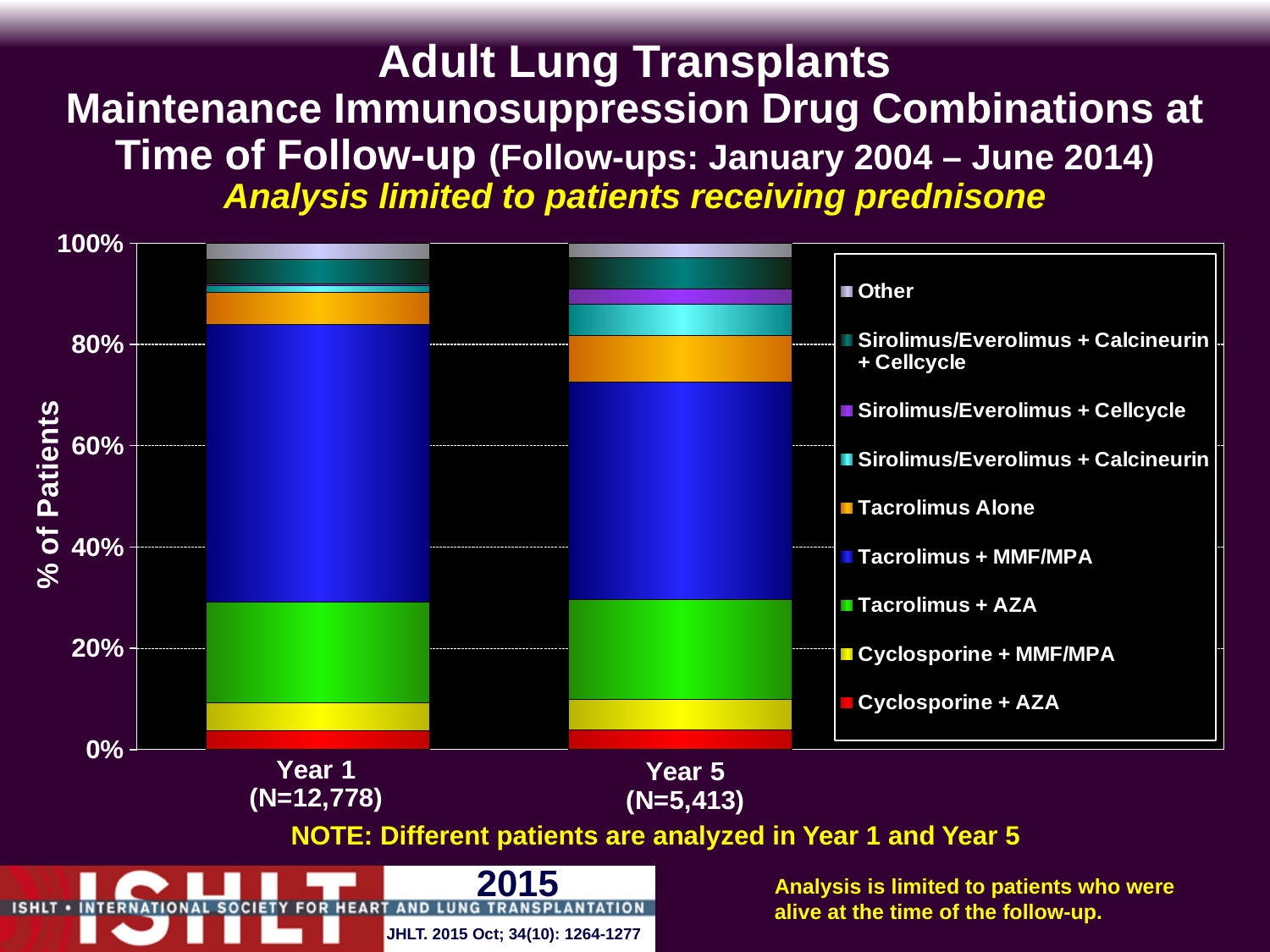
Is the share of Cyclosporine + AZA in Year 1 greater or less than 20%? less How many bars (follow-up time points) are plotted in the chart? 2 Which drug combination makes up the largest segment of the Year 1 bar? Tacrolimus + MMF/MPA What is the label of the y axis? % of Patients What is the N shown for the Year 1 bar? N=12,778 What is the N shown for the Year 5 bar? N=5,413 Is the share of Tacrolimus + MMF/MPA larger in Year 1 or Year 5? Year 1 Which drug combination makes up the largest segment of the Year 5 bar? Tacrolimus + MMF/MPA Is the share of Sirolimus/Everolimus + Calcineurin larger in Year 1 or Year 5? Year 5 Is the share of Tacrolimus + MMF/MPA in Year 1 greater or less than 40%? greater What kind of chart is shown on the slide? Stacked bar chart How many drug combination series does the legend list? 9